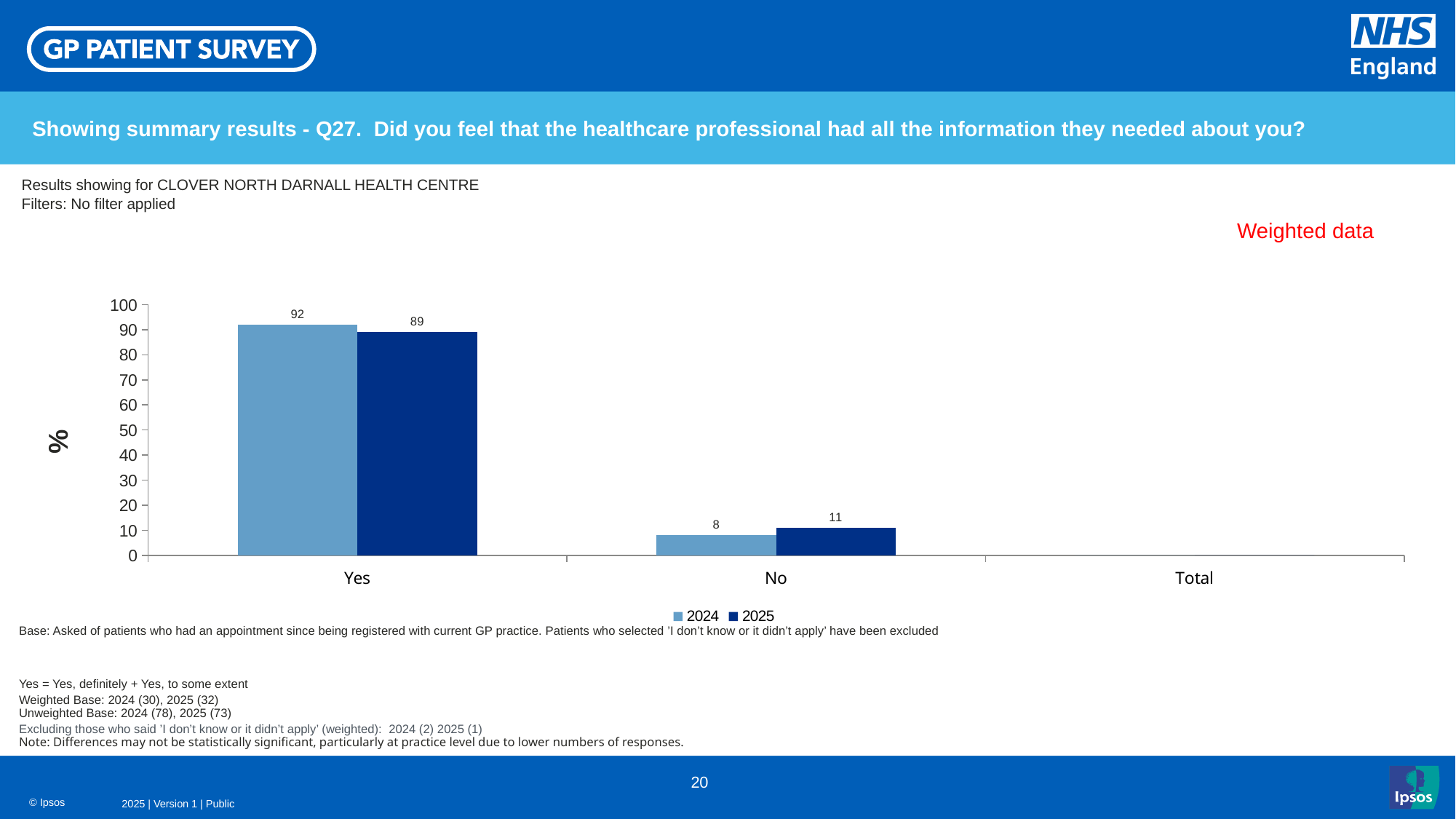
Which category has the highest value for the 2025 series? Yes What is the value for 2025 in the No category? 11 What is the value for 2024 in the Yes category? 92 What is the value for 2025 in the Yes category? 89 Which category has the lowest value for the 2024 series? No Is the 2025 value for Yes greater or less than 80? greater What kind of chart is shown on the slide? Bar chart What is the difference between the 2024 and 2025 values in the Yes category? 3 How many series does the legend list? 2 Which is larger in the No category, the 2024 value or the 2025 value? 2025 Which series is shown in the darker blue colour? 2025 What is the value for 2024 in the No category? 8